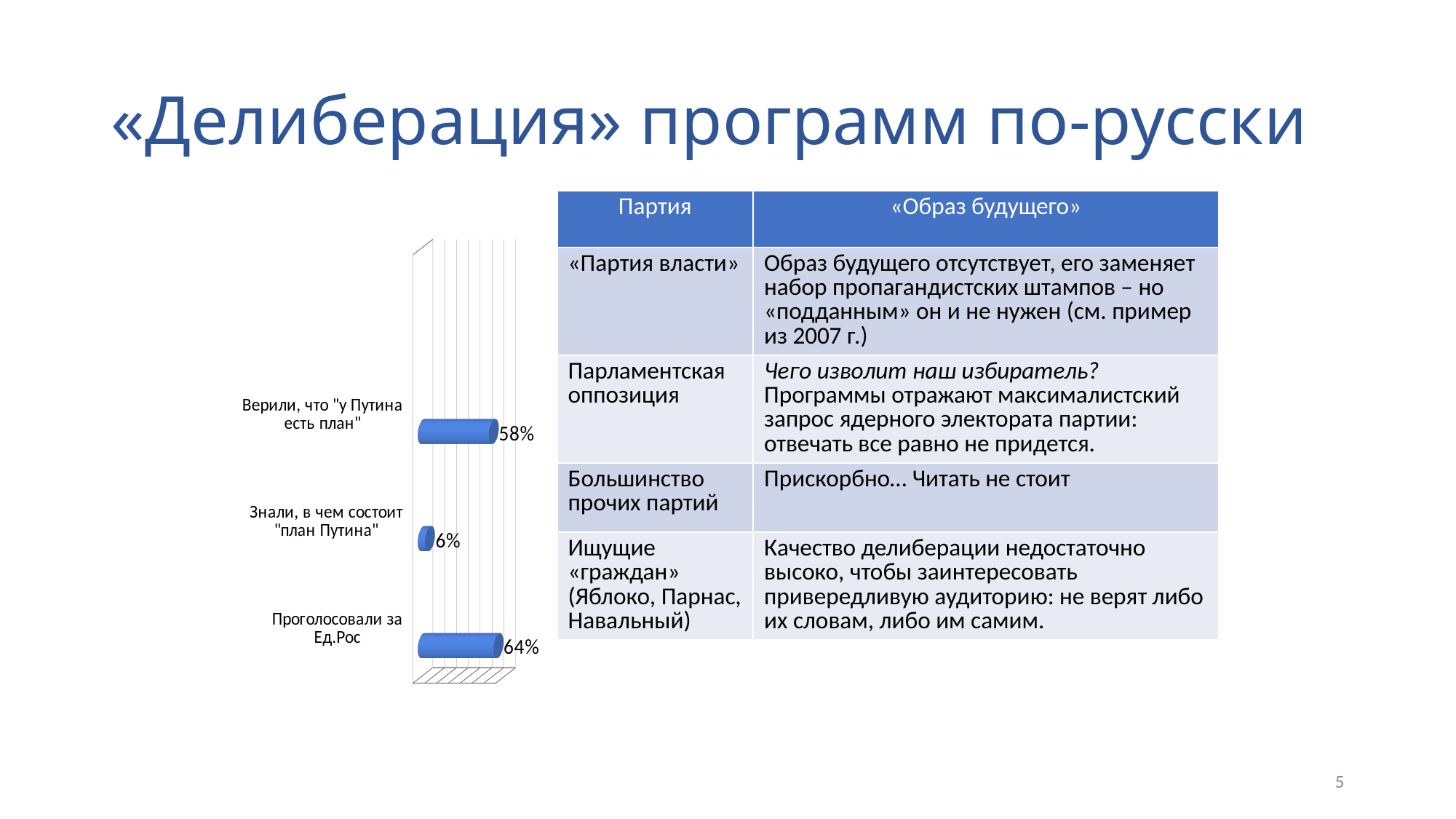
Which category has the highest value? Проголосовали за Ед.Рос What kind of chart is shown on the slide? Bar chart What is the value for "Знали, в чем состоит "план Путина""? 6% Which category has the lowest value? Знали, в чем состоит "план Путина" What is the value for "Проголосовали за Ед.Рос"? 64% What is the difference between the values for "Проголосовали за Ед.Рос" and "Верили, что "у Путина есть план""? 6% Which is larger: the value for "Проголосовали за Ед.Рос" or the value for "Верили, что "у Путина есть план""? Проголосовали за Ед.Рос How many categories are shown in the chart? 3 What is the value for "Верили, что "у Путина есть план""? 58% What is the difference between the values for "Верили, что "у Путина есть план"" and "Знали, в чем состоит "план Путина""? 52% What colour are the bars in the chart? Blue Which is larger: the value for "Знали, в чем состоит "план Путина"" or the value for "Верили, что "у Путина есть план""? Верили, что "у Путина есть план"